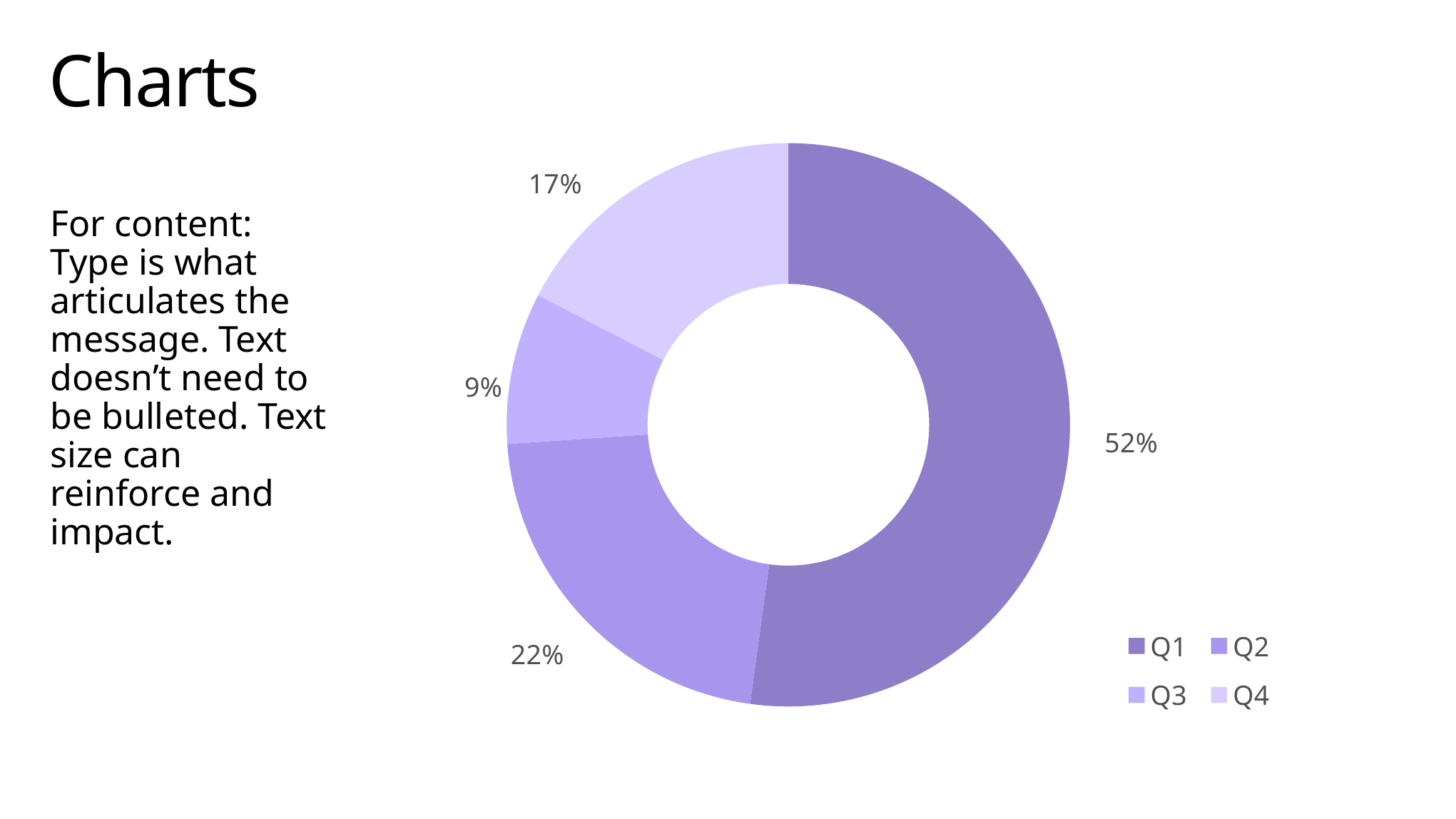
Which quarter has the largest share? Q1 What is the title of the slide containing the chart? Charts What is the difference in percentage points between Q1 and Q2? 30 Which quarter has the smallest share? Q3 What percentage does Q2 represent? 22% How many categories does the chart show? 4 What percentage does Q3 represent? 9% How many entries does the legend list? 4 Which is larger, the share for Q4 or the share for Q3? Q4 What percentage does Q4 represent? 17% What kind of chart is shown on the slide? Doughnut chart What percentage does Q1 represent? 52%